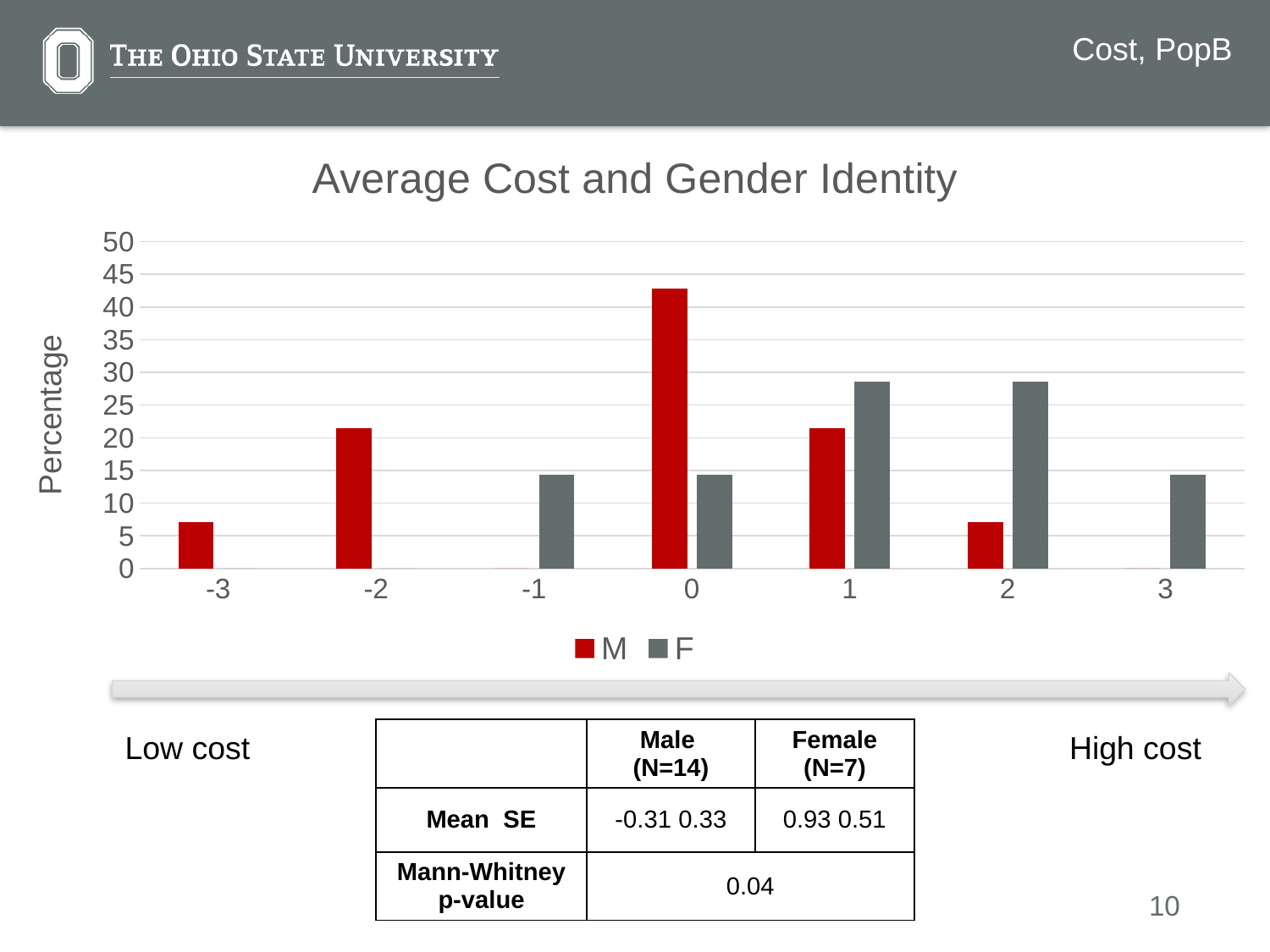
Is the value for M at category -3 greater or less than 10? less What is the label of the y axis of the chart? Percentage Is the value for M at category 0 greater or less than 40? greater Is the value for F at category 1 greater or less than 25? greater At category 0, which series has the larger value, M or F? M What kind of chart is shown on the slide? bar chart Which category has the highest value for the M series? 0 At category 1, which series has the larger value, M or F? F What is the title of the chart? Average Cost and Gender Identity How many series does the chart legend list? 2 How many categories are shown on the x axis of the chart? 7